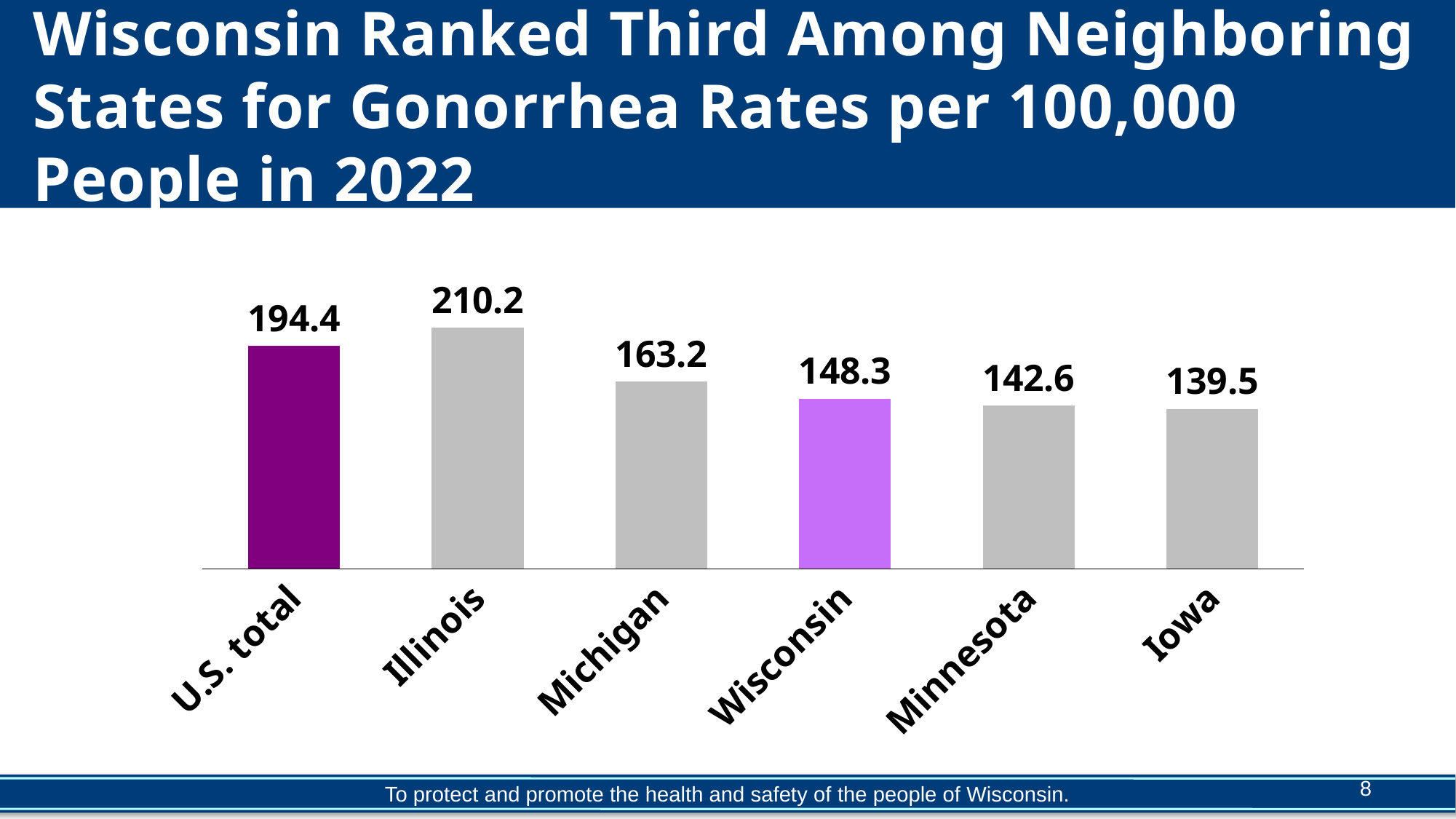
What is the value shown for the U.S. total? 194.4 What is the value shown for Illinois? 210.2 How many bars are shown in the chart? 6 What type of chart is shown on the slide? Bar chart Which category has the lowest value? Iowa What is the difference between the values for Illinois and Wisconsin? 61.9 What is the gonorrhea rate per 100,000 people for Wisconsin? 148.3 Which is larger, the value for Michigan or the value for Minnesota? Michigan Which category has the highest value? Illinois What is the difference between the U.S. total and Michigan? 31.2 What is the value shown for Iowa? 139.5 Which bar is shown in light purple? Wisconsin